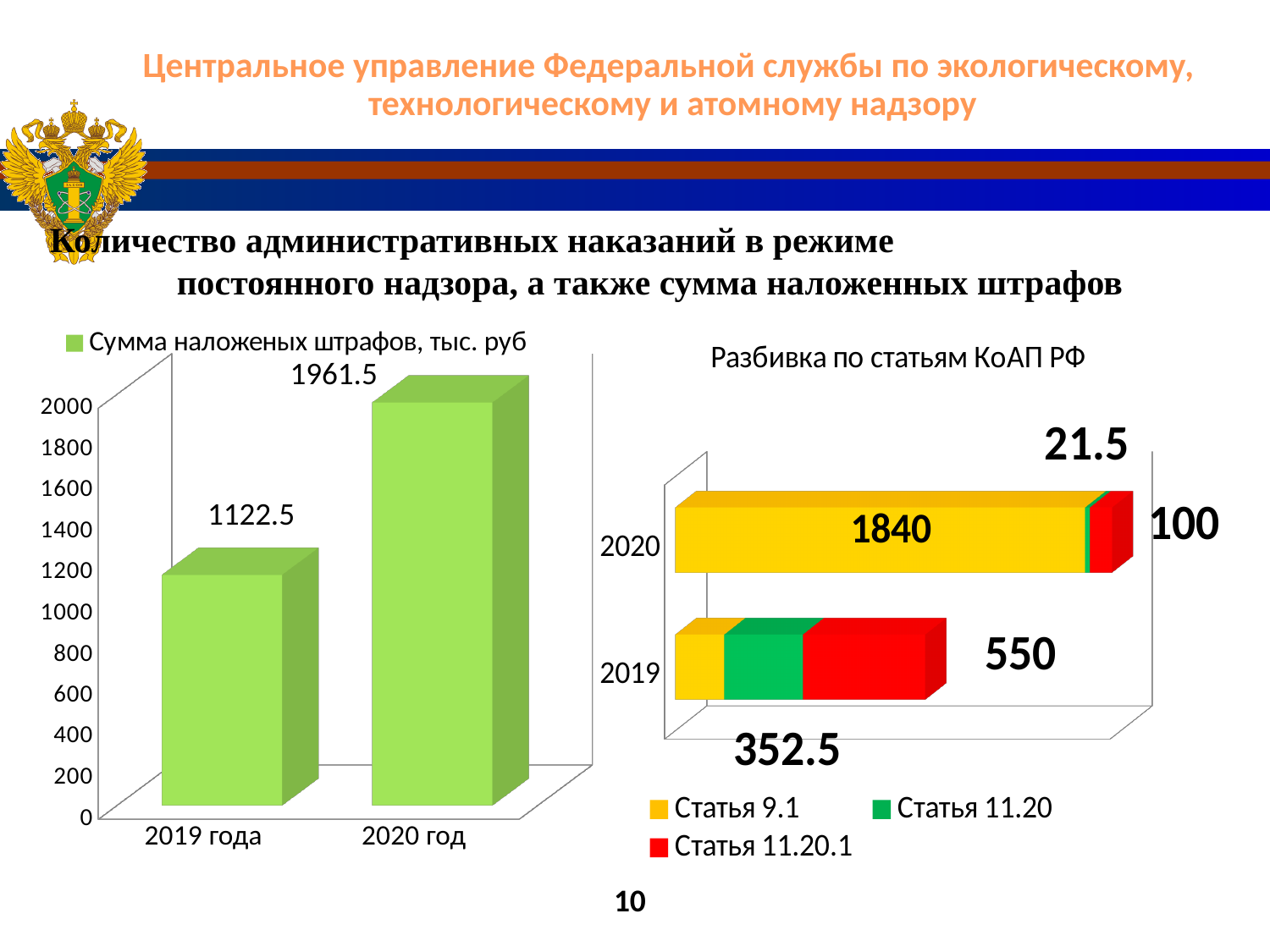
In the chart 'Разбивка по статьям КоАП РФ', what is the value of Статья 11.20.1 for 2019? 550 In the chart 'Разбивка по статьям КоАП РФ', how many series does the legend list? 3 In the chart 'Разбивка по статьям КоАП РФ', what is the value of Статья 9.1 for 2020? 1840 In the chart 'Разбивка по статьям КоАП РФ', what is the total of the stacked bar for 2020? 1961.5 In the left chart, what series name does the legend show? Сумма наложеных штрафов, тыс. руб In the chart 'Разбивка по статьям КоАП РФ', what is the value of Статья 11.20 for 2020? 21.5 In the left chart, what is the difference between the 2020 год and 2019 года values? 839 What kind of chart is 'Разбивка по статьям КоАП РФ'? Stacked bar chart In the left chart, is the value for 2019 года greater or less than 1000? greater In the left chart, what is the value for 2020 год? 1961.5 In the left chart, which year has the higher value? 2020 год In the left chart, what is the value for 2019 года? 1122.5